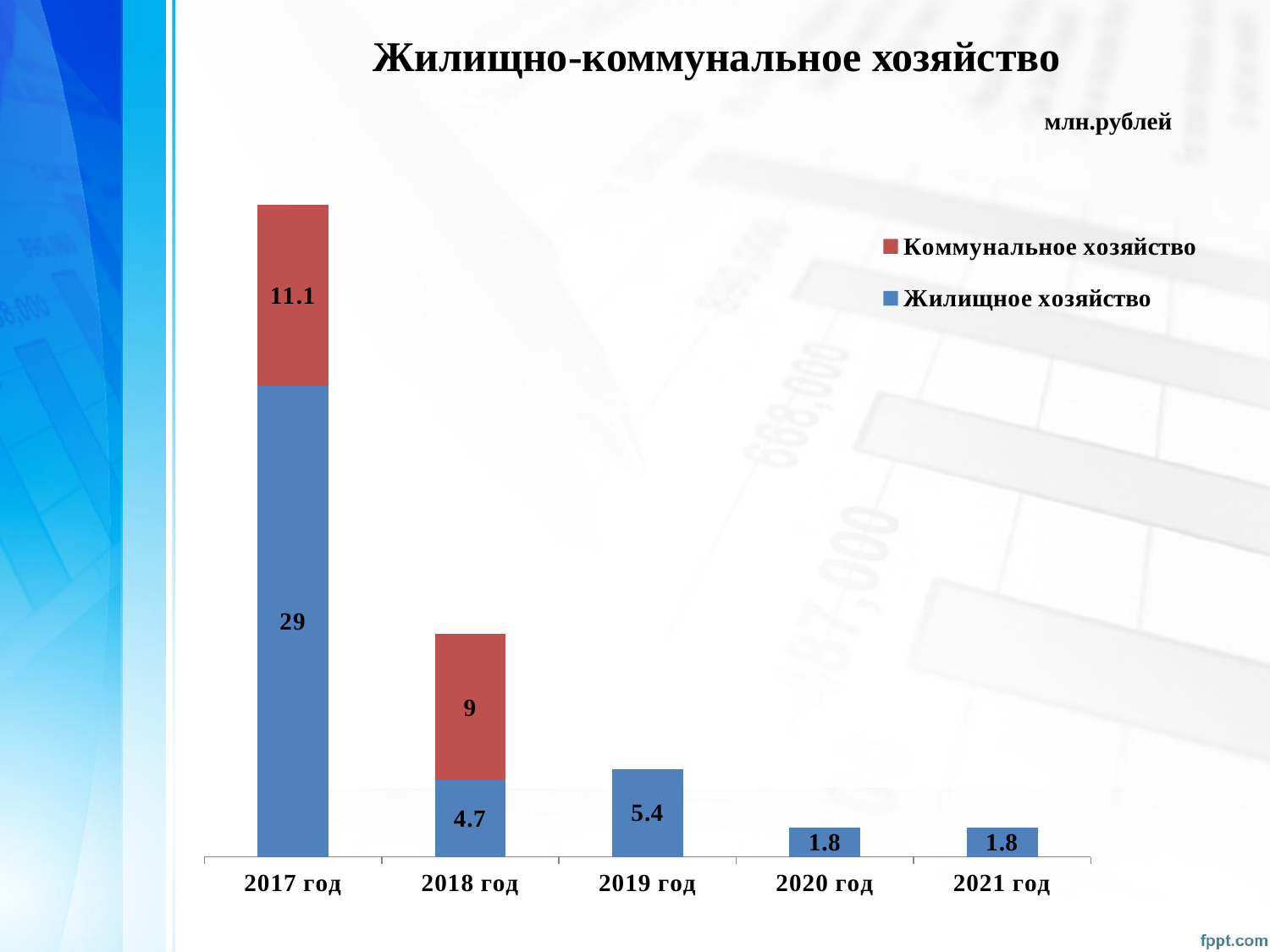
What is the value of Жилищное хозяйство for 2019 год? 5.4 Which year has the highest value for Жилищное хозяйство? 2017 год What is the value of Жилищное хозяйство for 2017 год? 29 What is the difference between the Коммунальное хозяйство values for 2017 год and 2018 год? 2.1 How many series does the legend list? 2 Which is larger: Жилищное хозяйство in 2018 год or in 2019 год? 2019 год What is the value of Коммунальное хозяйство for 2018 год? 9 What is the total of the stacked bar for 2017 год? 40.1 What is the value of Жилищное хозяйство for 2021 год? 1.8 How many years are shown on the x axis? 5 What is the total of the stacked bar for 2018 год? 13.7 What type of chart is shown on the slide? Stacked bar chart